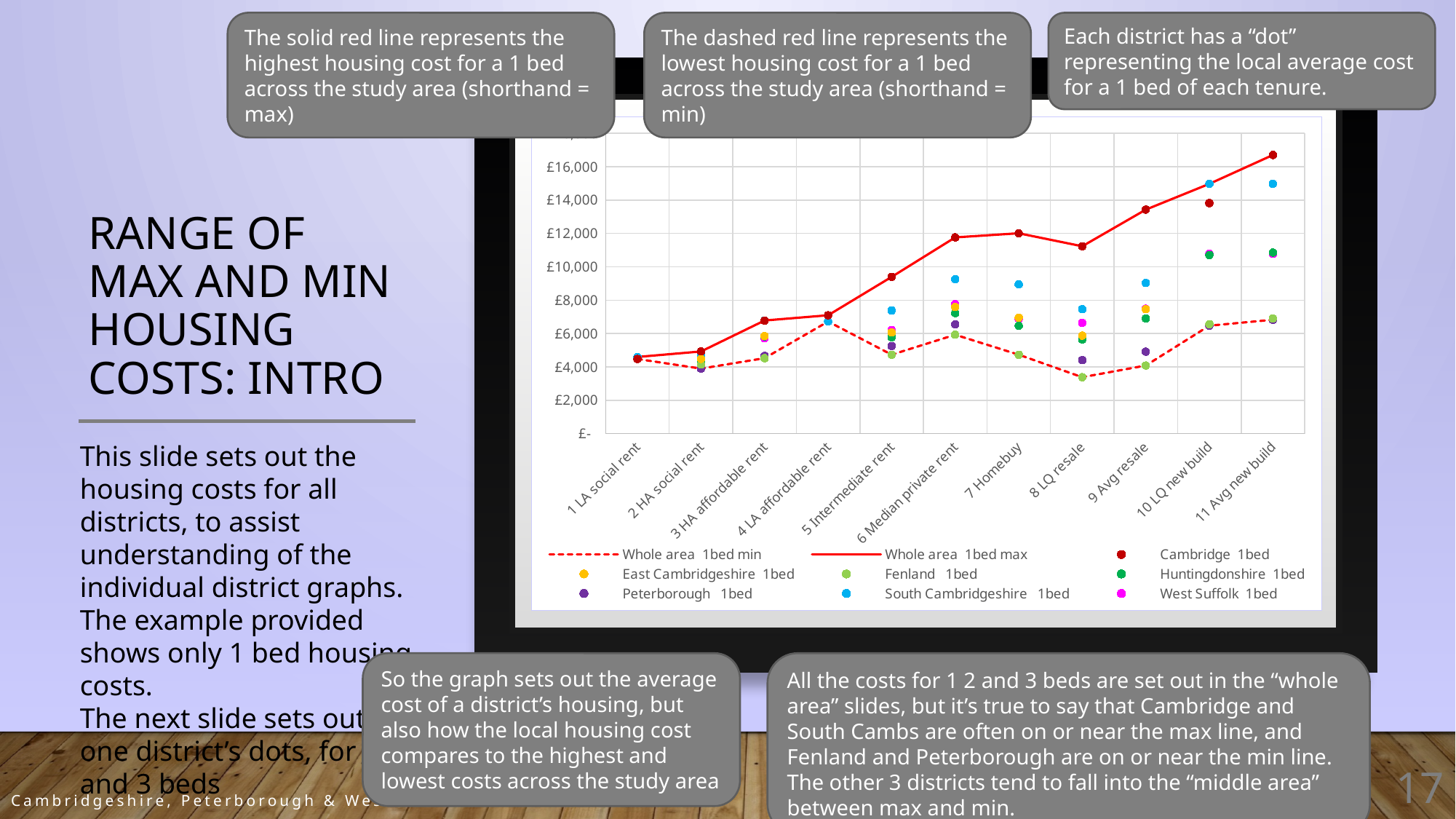
Is the Whole area 1bed max value for 11 Avg new build greater or less than £16,000? greater Which category has the highest value on the Whole area 1bed max line? 11 Avg new build How many categories are shown along the x axis of the chart? 11 At 10 LQ new build, which is larger: the Cambridge 1bed value or the Fenland 1bed value? Cambridge 1bed Which category has the lowest value on the Whole area 1bed min line? 8 LQ resale What colour is the Whole area 1bed max line in the chart? red How many series does the chart's legend list? 9 Is the Whole area 1bed min value for 8 LQ resale greater or less than £4,000? less Is the Whole area 1bed max value for 6 Median private rent greater or less than £10,000? greater What kind of chart is shown on the slide? line chart Does the Whole area 1bed max line generally rise or fall from 1 LA social rent to 11 Avg new build? rise